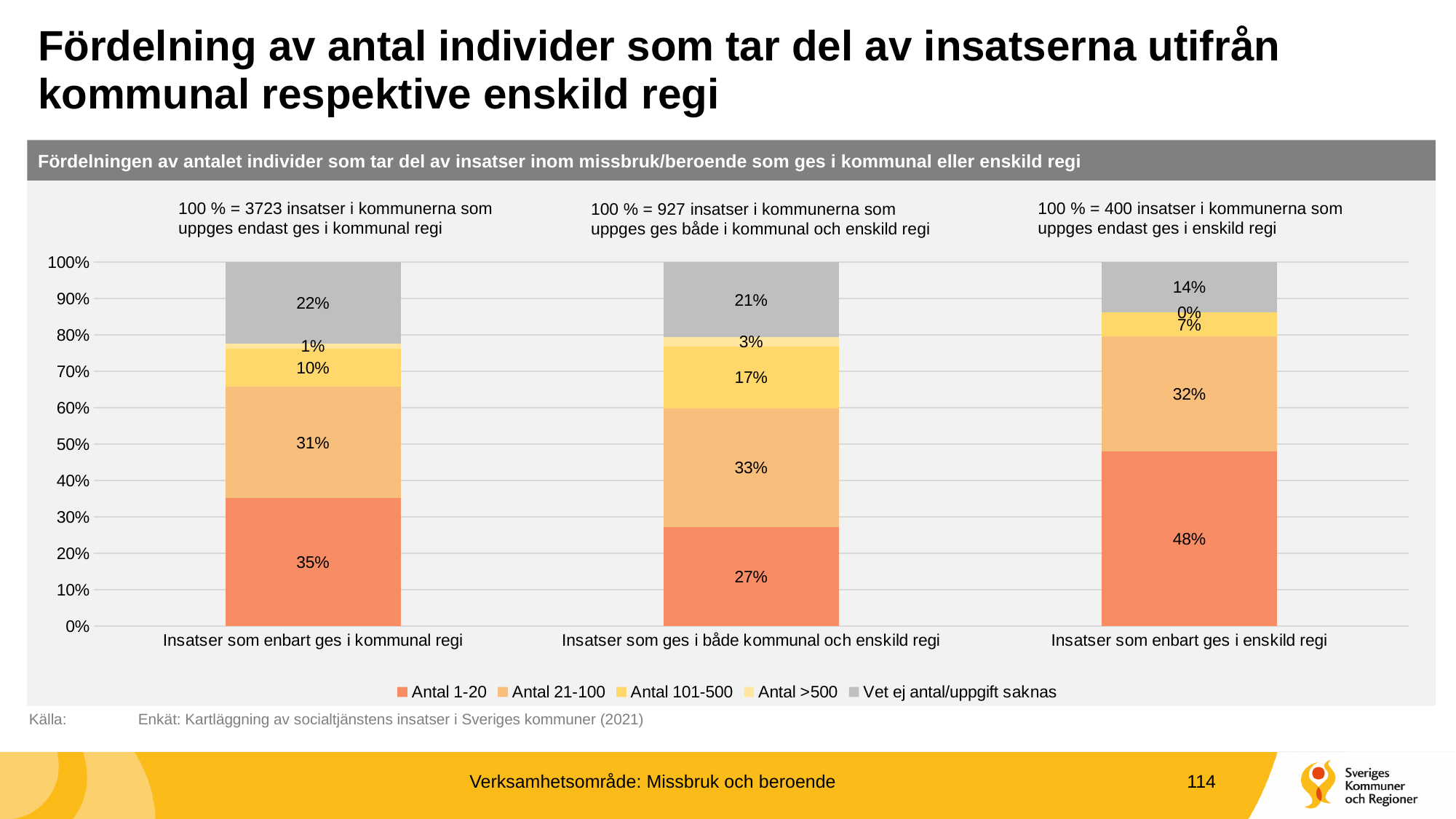
What share of 'Insatser som enbart ges i kommunal regi' falls in the 'Antal 1-20' category? 35% What is the 'Antal 21-100' value for 'Insatser som ges i både kommunal och enskild regi'? 33% According to the note above the chart, how many insatser does 100% represent for 'Insatser som enbart ges i enskild regi'? 400 What kind of chart is shown on the slide? Stacked bar chart Which category has the lowest 'Antal >500' share? Insatser som enbart ges i enskild regi Which category has the highest 'Antal 1-20' share? Insatser som enbart ges i enskild regi What is the 'Antal 101-500' value for 'Insatser som enbart ges i kommunal regi'? 10% How many categories are shown on the x axis? 3 Which is larger: the 'Antal 101-500' share for 'Insatser som ges i både kommunal och enskild regi' or for 'Insatser som enbart ges i enskild regi'? Insatser som ges i både kommunal och enskild regi What is the 'Vet ej antal/uppgift saknas' share for 'Insatser som enbart ges i enskild regi'? 14% What is the difference between the 'Antal 1-20' shares for 'Insatser som enbart ges i enskild regi' and 'Insatser som ges i både kommunal och enskild regi'? 21 percentage points How many series does the legend list? 5